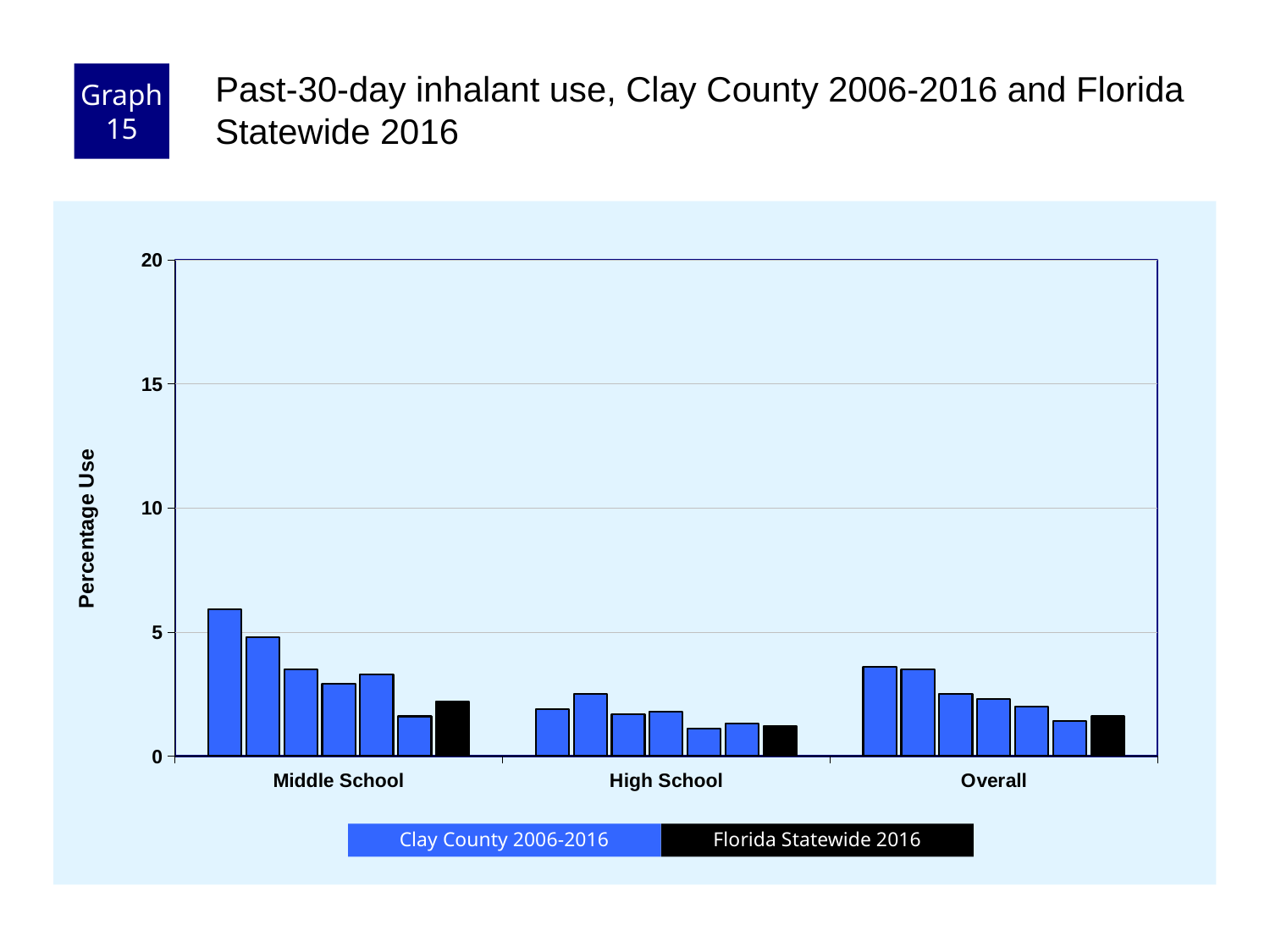
Which is larger: the tallest Clay County bar in the Middle School group or the tallest Clay County bar in the High School group? Middle School Which is larger: the Florida Statewide 2016 bar for Middle School or the Florida Statewide 2016 bar for High School? Middle School How many series does the legend list? 2 How many categories are shown along the x axis? 3 What are the two series named in the legend? Clay County 2006-2016 and Florida Statewide 2016 What kind of chart is shown on the slide? bar chart Is the value for the tallest Clay County bar in the Middle School group greater or less than 5? greater Which category group contains the tallest bar on the chart? Middle School Is the value for the Florida Statewide 2016 bar in the Middle School group greater or less than 5? less What is the title of the y axis? Percentage Use Is the value for the Florida Statewide 2016 bar in the High School group greater or less than 5? less Do the Clay County 2006-2016 bars in the Middle School group generally rise or fall from left to right? fall